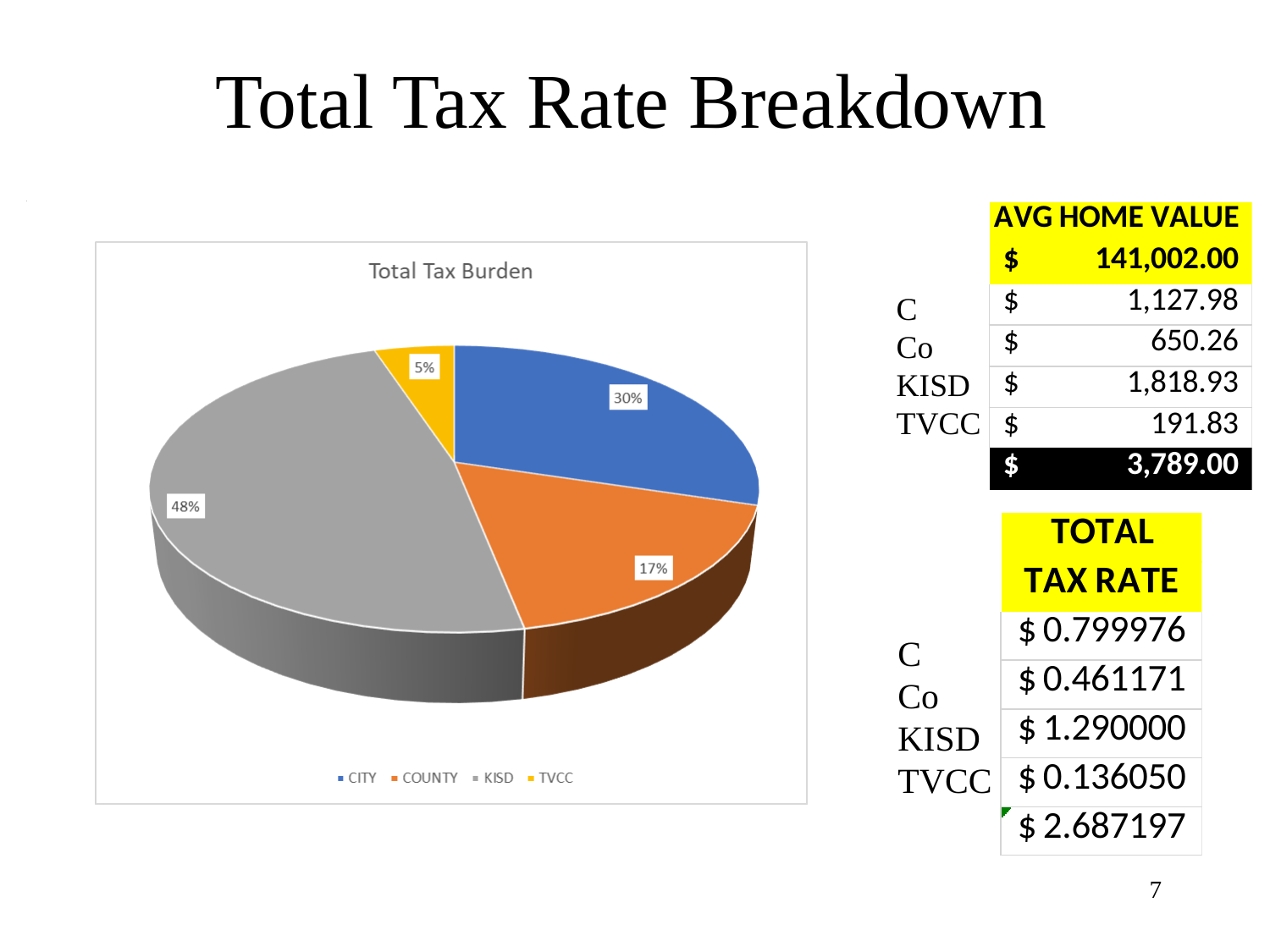
What share of the Total Tax Burden pie does TVCC account for? 5% In the Total Tax Burden pie chart, how many percentage points larger is the COUNTY slice than the TVCC slice? 12 What share of the Total Tax Burden pie does COUNTY account for? 17% What type of chart is shown on the slide? Pie chart What share of the Total Tax Burden pie does CITY account for? 30% Which category has the largest slice in the Total Tax Burden pie chart? KISD What is the title of the chart on the slide? Total Tax Burden How many slices does the Total Tax Burden pie chart have? 4 Which category has the smallest slice in the Total Tax Burden pie chart? TVCC In the Total Tax Burden pie chart, which slice is larger, CITY or COUNTY? CITY In the Total Tax Burden pie chart, how many percentage points larger is the KISD slice than the CITY slice? 18